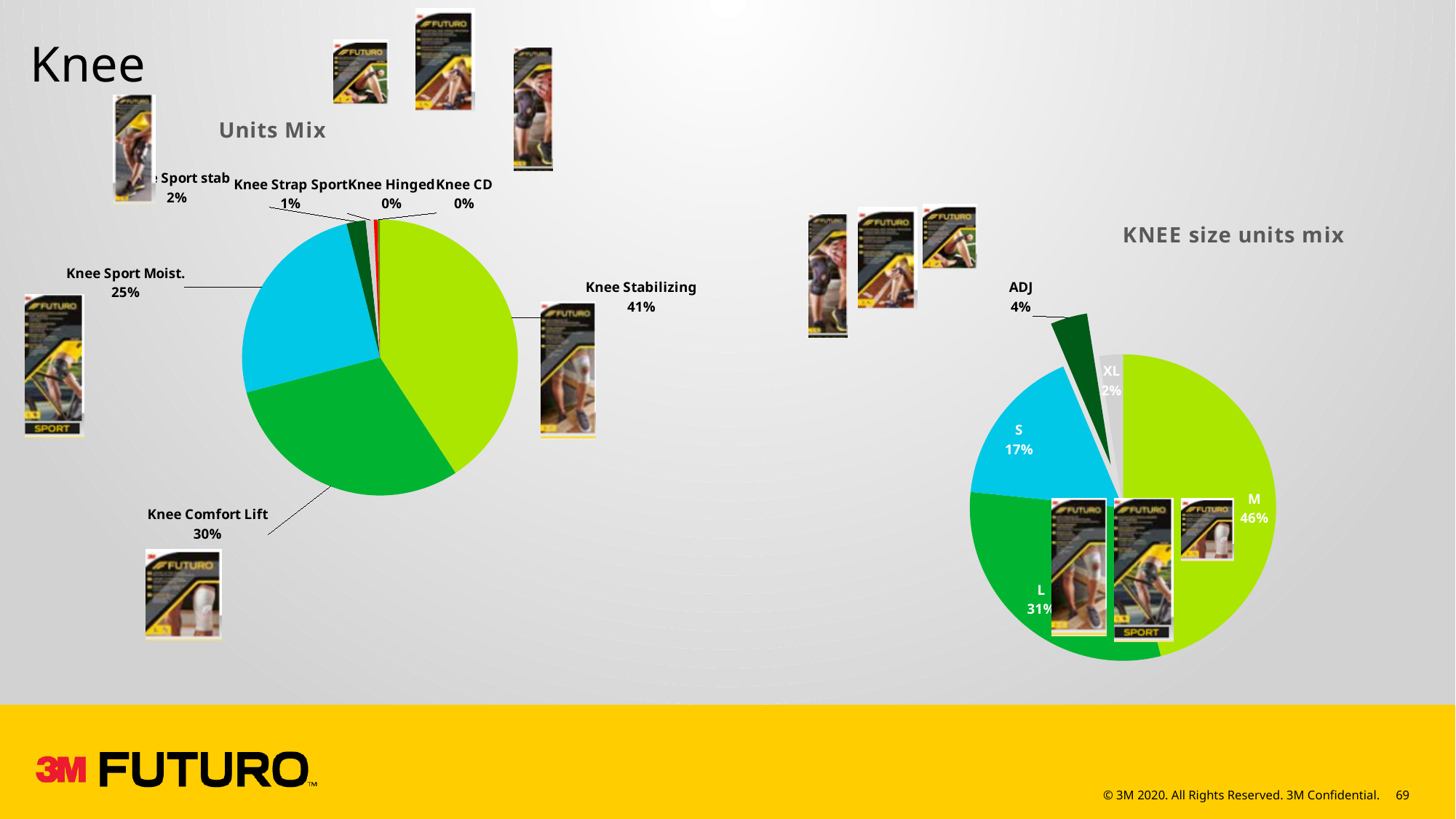
How many slices does the KNEE size units mix chart have? 5 In the Units Mix chart, what share does Knee Sport Moist. have? 25% In the Units Mix chart, what is the difference between the shares of Knee Stabilizing and Knee Comfort Lift? 11% In the Units Mix chart, which is larger, Knee Comfort Lift or Knee Sport Moist.? Knee Comfort Lift In the KNEE size units mix chart, what is the difference between the shares of S and ADJ? 13% In the KNEE size units mix chart, what share does size L have? 31% In the Units Mix chart, which category has the largest share? Knee Stabilizing In the KNEE size units mix chart, which size has the smallest share? XL In the Units Mix chart, what share does Knee Stabilizing have? 41% In the KNEE size units mix chart, what share does size M have? 46% In the Units Mix chart, what share does Knee Comfort Lift have? 30% What kind of chart is the Units Mix chart? Pie chart